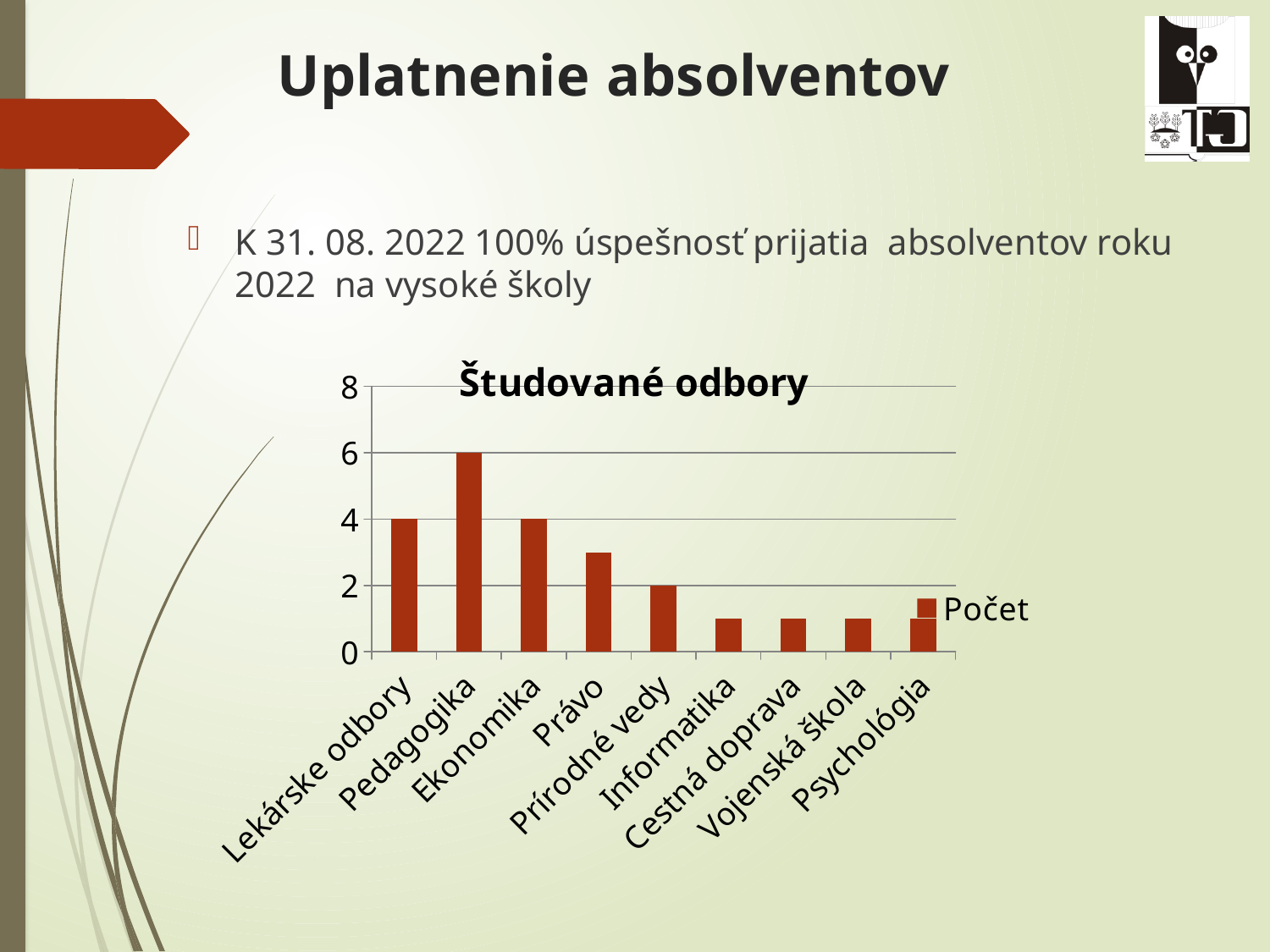
What is the value for Lekárske odbory in the "Študované odbory" chart? 4 What is the value for Prírodné vedy in the "Študované odbory" chart? 2 What is the difference between the values for Pedagogika and Ekonomika in the "Študované odbory" chart? 2 How many series does the legend of the "Študované odbory" chart list? 1 Which category has the highest value in the "Študované odbory" chart? Pedagogika Which is larger in the "Študované odbory" chart, the value for Pedagogika or the value for Lekárske odbory? Pedagogika How many categories are shown on the x axis of the "Študované odbory" chart? 9 What type of chart is shown under the title "Študované odbory"? bar chart Is the value for Informatika in the "Študované odbory" chart greater or less than 2? less What is the name of the series shown in the legend of the "Študované odbory" chart? Počet Is the value for Právo in the "Študované odbory" chart greater or less than 4? less What is the value for Pedagogika in the "Študované odbory" chart? 6